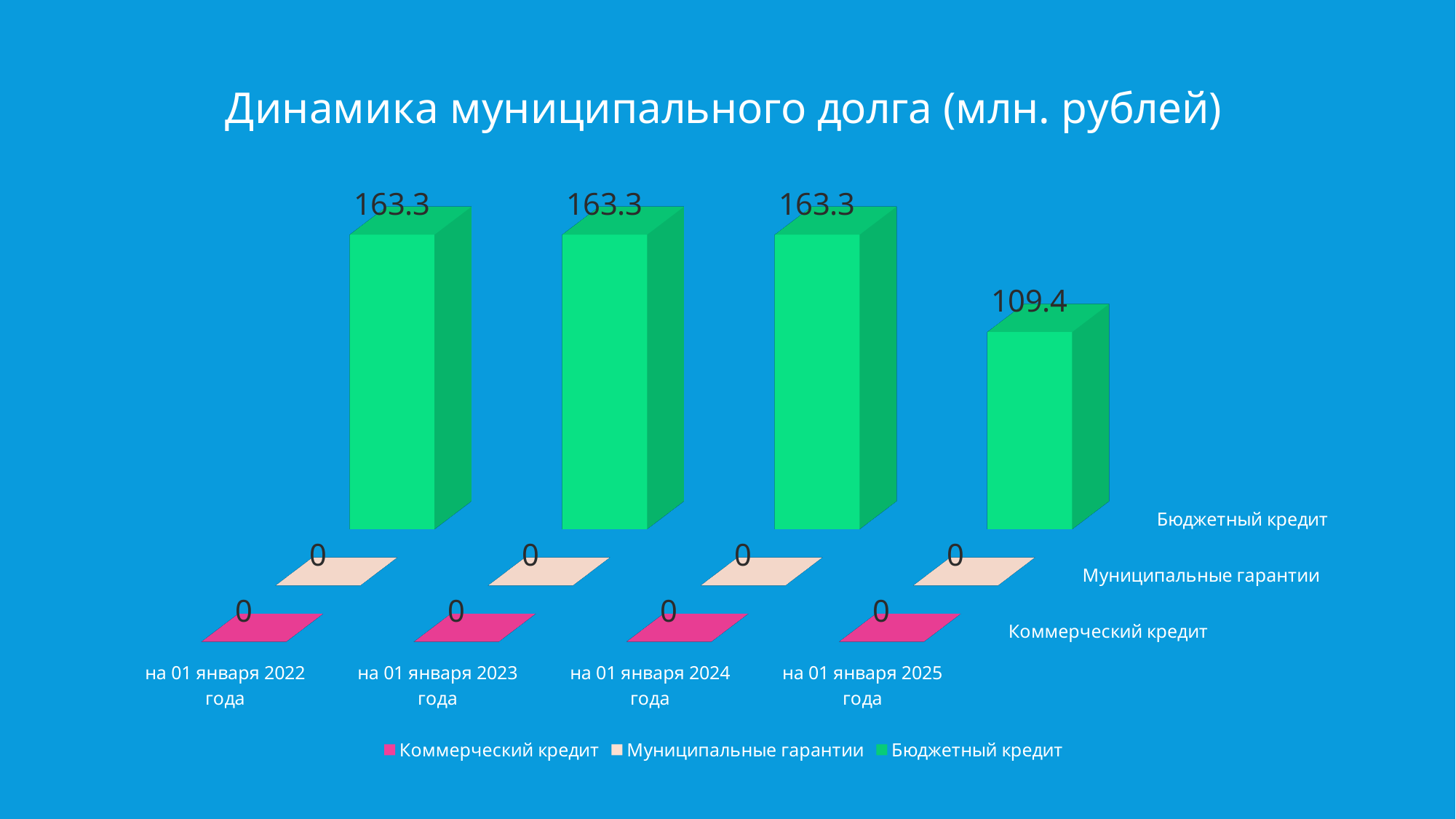
Which date has the lowest value for Бюджетный кредит? на 01 января 2025 года What is the title of the chart? Динамика муниципального долга (млн. рублей) What is the difference between the Бюджетный кредит value on 01 января 2024 года and on 01 января 2025 года? 53.9 Which is larger: Бюджетный кредит on 01 января 2023 года or on 01 января 2025 года? на 01 января 2023 года What kind of chart is shown on the slide? bar chart What is the value of Муниципальные гарантии on 01 января 2023 года? 0 What is the value of Бюджетный кредит on 01 января 2025 года? 109.4 Does the Бюджетный кредит series rise or fall from 01 января 2024 года to 01 января 2025 года? fall What is the value of Бюджетный кредит on 01 января 2022 года? 163.3 What is the value of Коммерческий кредит on 01 января 2024 года? 0 How many dates (categories) are shown on the x axis? 4 How many series does the legend list? 3